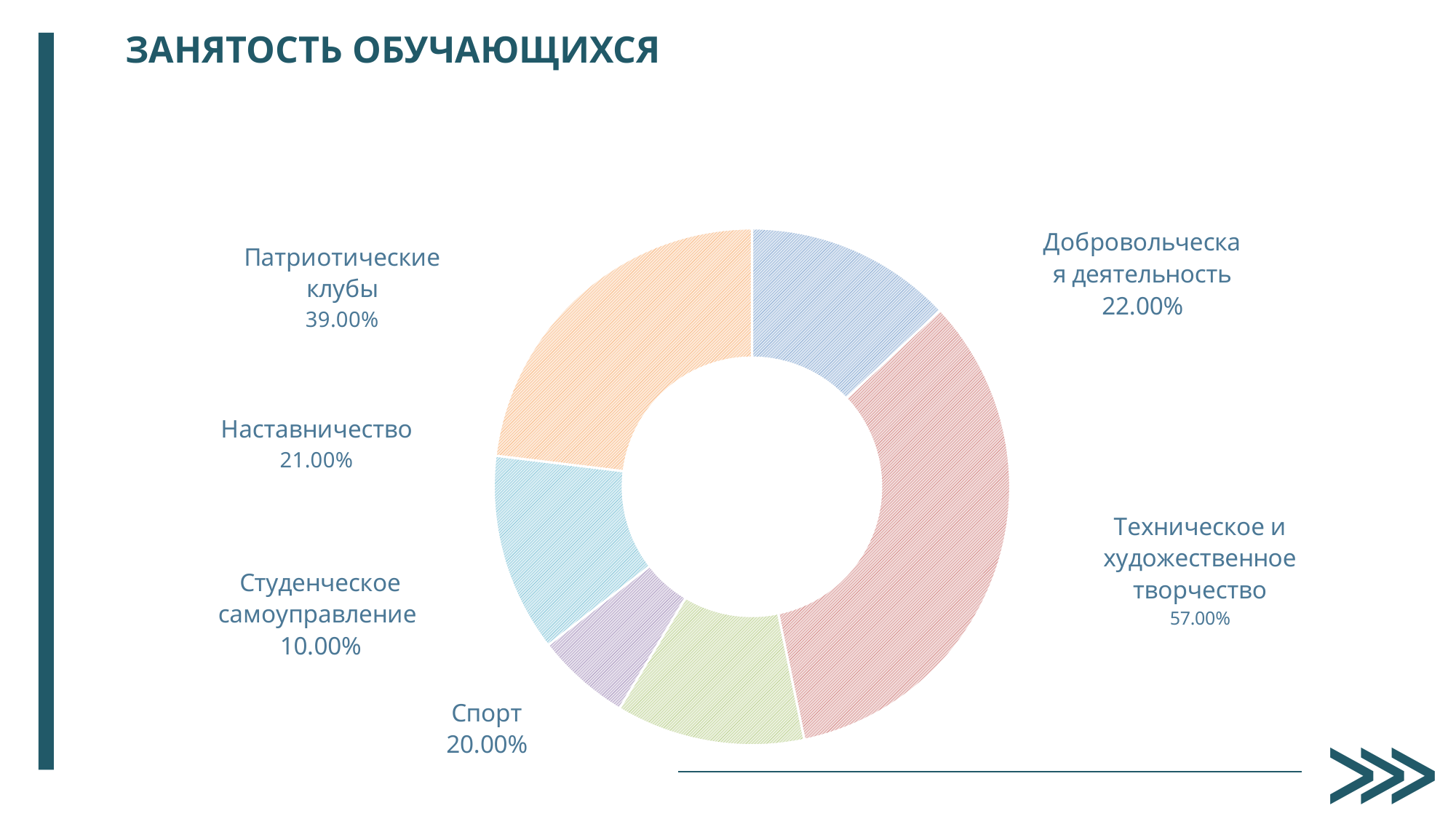
What is the difference between the values for Добровольческая деятельность and Студенческое самоуправление? 12.00% How many categories are shown in the chart? 6 What value is shown for Техническое и художественное творчество? 57.00% What is the title of the slide? ЗАНЯТОСТЬ ОБУЧАЮЩИХСЯ Which category has the lowest value? Студенческое самоуправление What value is shown for Спорт? 20.00% What value is shown for Наставничество? 21.00% Which is larger, the value for Патриотические клубы or the value for Добровольческая деятельность? Патриотические клубы What is the difference between the values for Техническое и художественное творчество and Патриотические клубы? 18.00% What value is shown for Патриотические клубы? 39.00% Which category has the highest value? Техническое и художественное творчество What kind of chart is shown on the slide? Doughnut chart